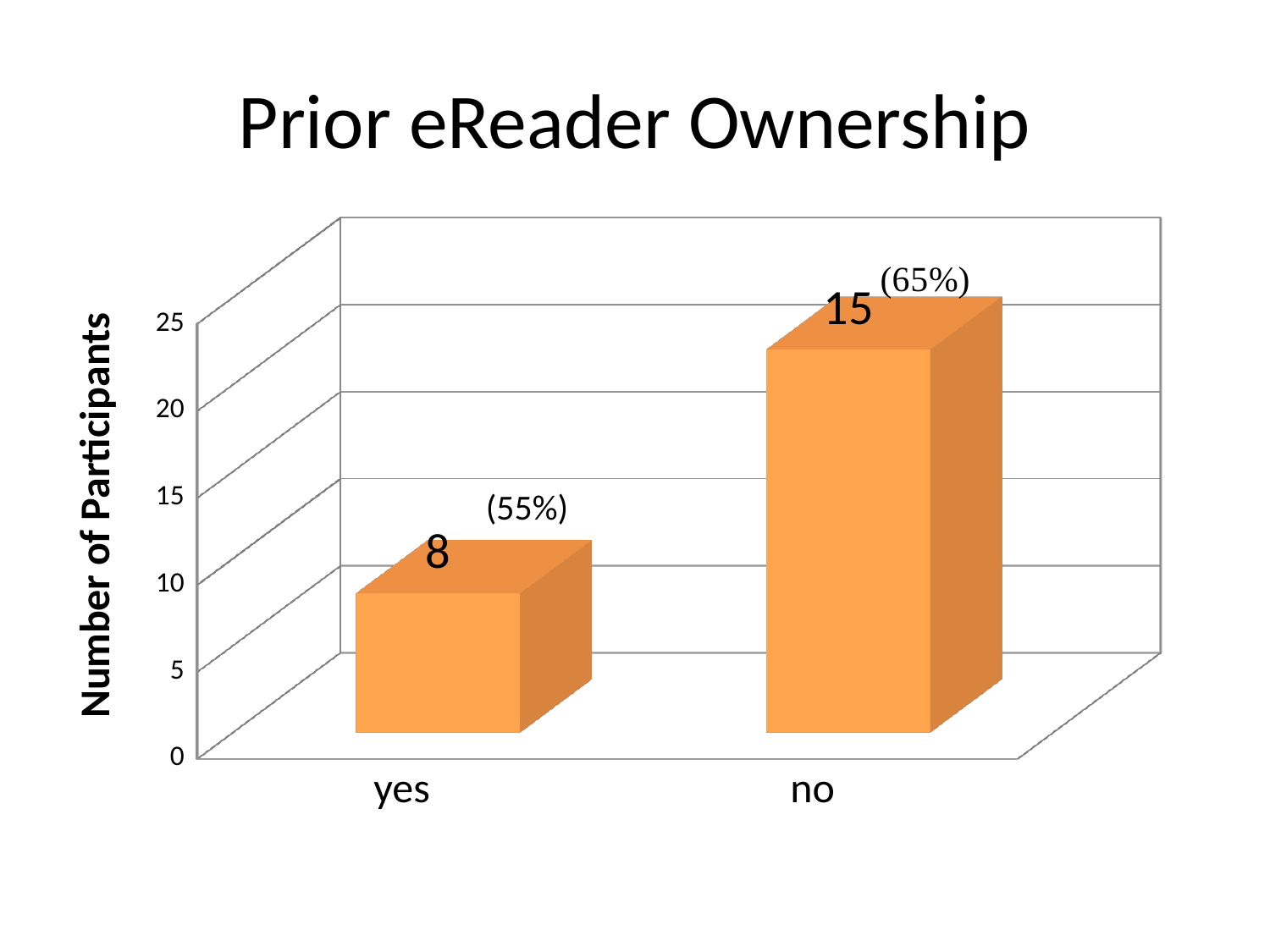
What is the title of the chart? Prior eReader Ownership What is the number of participants for "yes"? 8 What is the label of the vertical axis? Number of Participants What is the difference in number of participants between "no" and "yes"? 7 What kind of chart is shown on the slide? bar chart Is the value for "no" greater or less than 10? greater Which category has the lowest number of participants? yes What is the number of participants for "no"? 15 Which has more participants, "yes" or "no"? no Which category has the highest number of participants? no How many categories are shown on the x axis? 2 Is the value for "yes" greater or less than 10? less